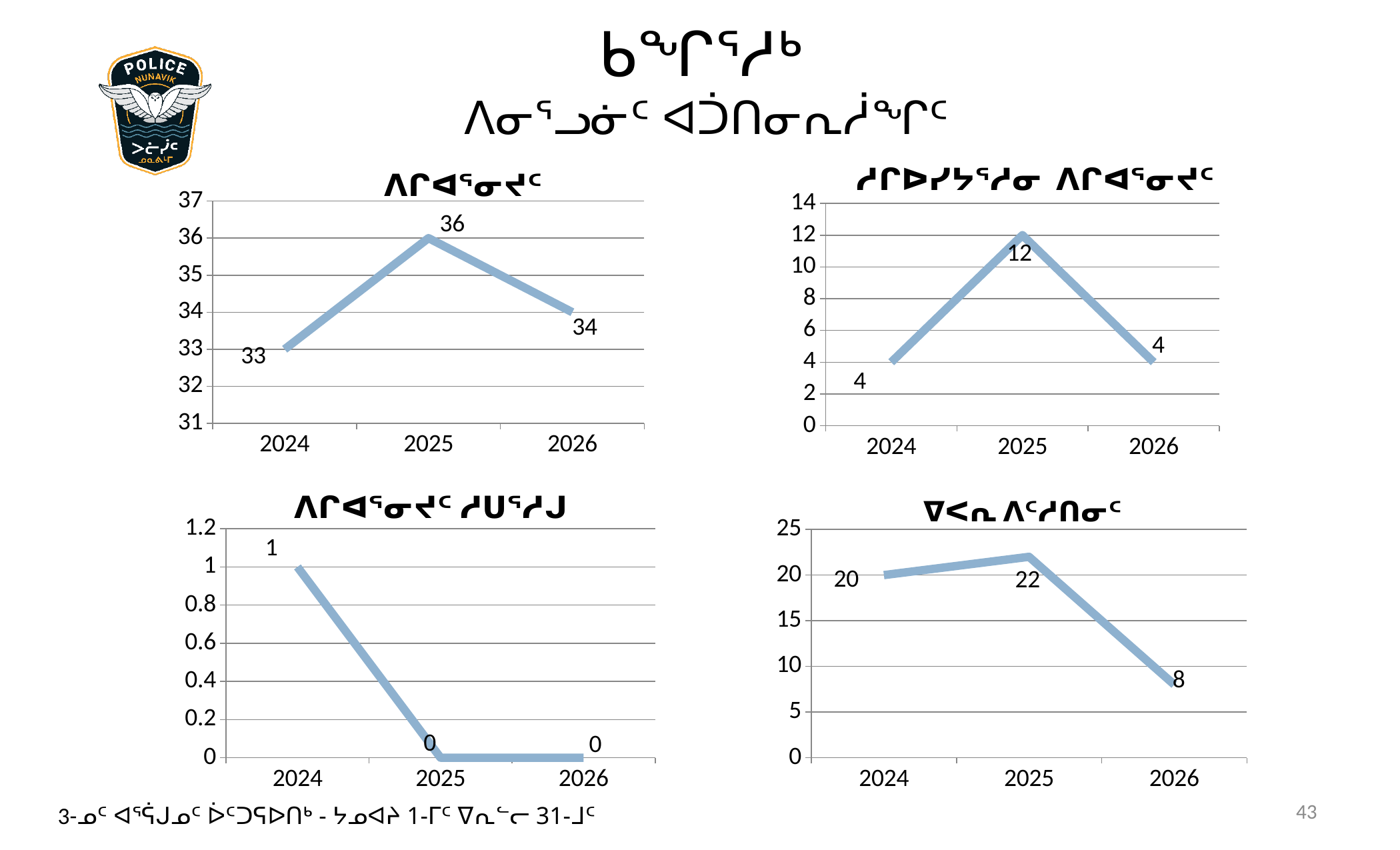
In the top-left chart, which year has the lowest value? 2024 In the top-right chart, which year has the highest value? 2025 In the top-left chart, what is the difference between the 2025 and 2024 values? 3 In the top-right chart, what is the difference between the 2025 and 2026 values? 8 In the bottom-left chart, do the values rise or fall from 2024 to 2026? fall In the bottom-right chart, what is the value for 2026? 8 In the bottom-left chart, what is the value for 2024? 1 In the top-right chart, what is the value for 2025? 12 What kind of chart is the bottom-right chart? line chart In the bottom-right chart, what is the difference between the 2025 and 2026 values? 14 In the bottom-right chart, which is larger, the value for 2024 or the value for 2025? 2025 In the top-left chart, what is the value for 2025? 36